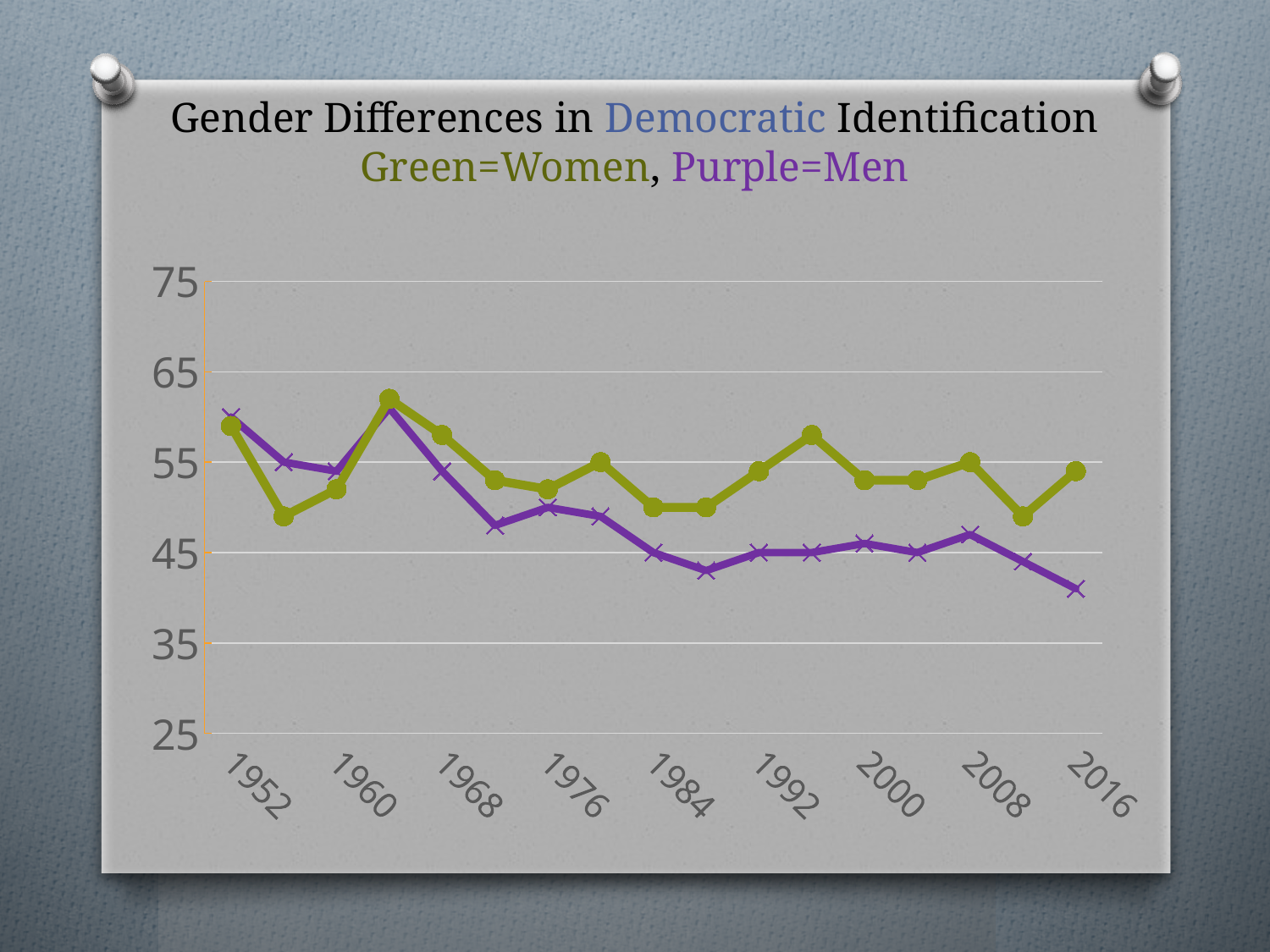
Which colour represents women in the chart? Green Is the value for women in 2016 greater or less than 45? greater What kind of chart is shown on the slide? line chart What is the title of the chart? Gender Differences in Democratic Identification Overall, does the men (purple) line rise or fall from 1952 to 2016? fall In 2008, which is larger, the value for women or the value for men? women How many year labels are shown on the x axis? 9 Is the value for men in 1984 greater or less than 55? less In which year does the women (green) line reach its highest value? 1964 In 2016, which is larger, the value for women or the value for men? women Is the value for men in 2016 greater or less than 45? less How many series does the chart plot? 2